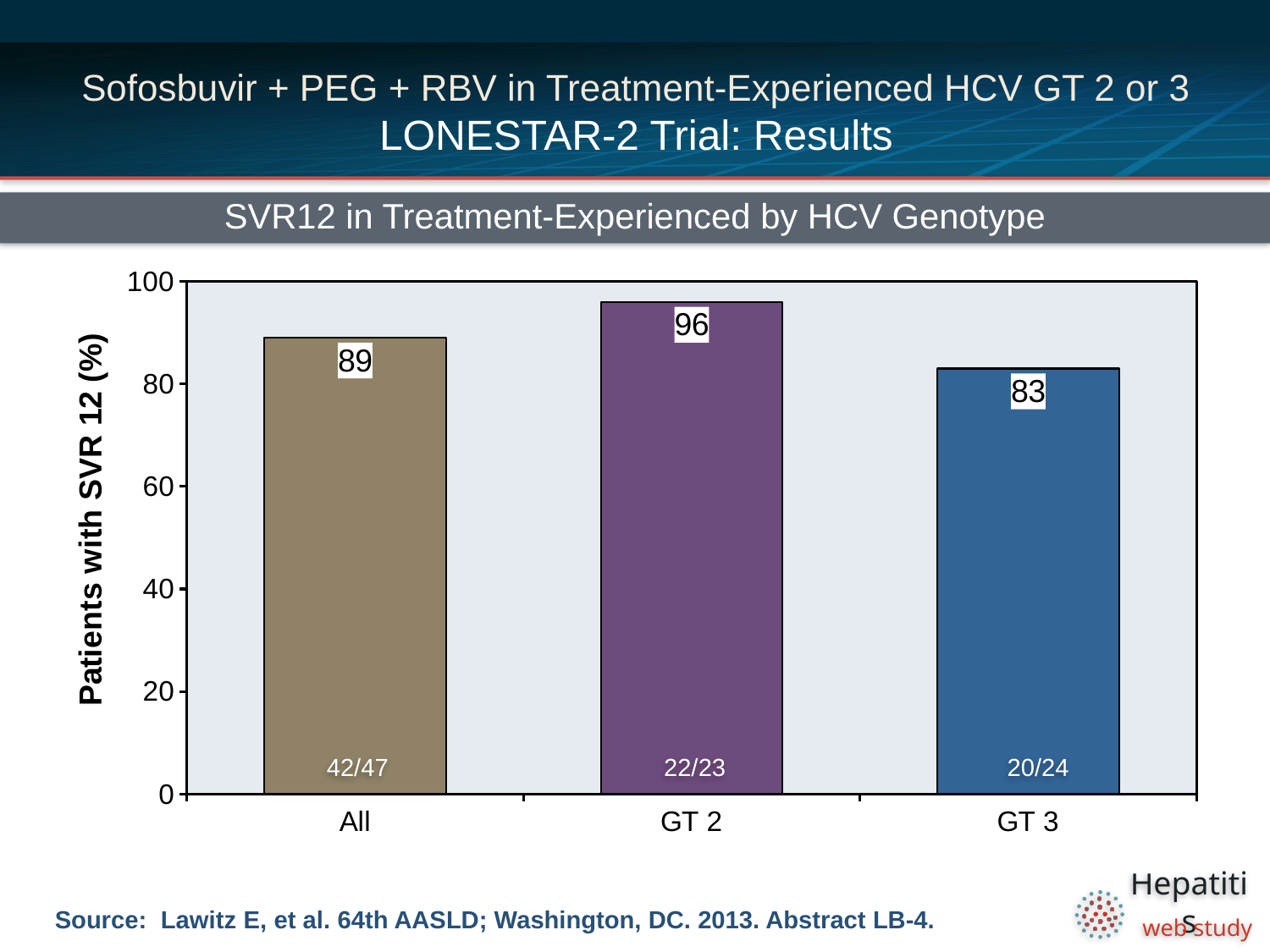
Which category has the lowest SVR12 value? GT 3 What kind of chart is shown on the slide? Bar chart Which category has the highest SVR12 value? GT 2 How many categories are shown on the x axis? 3 Which has a higher SVR12 value, All or GT 2? GT 2 What is the difference between the SVR12 values for All and GT 3? 6 What is the SVR12 value for GT 3? 83 What is the title of the chart? SVR12 in Treatment-Experienced by HCV Genotype What is the SVR12 value for the All group? 89 What is the difference between the SVR12 values for GT 2 and GT 3? 13 What fraction of patients is printed on the GT 3 bar? 20/24 What is the SVR12 value for GT 2? 96